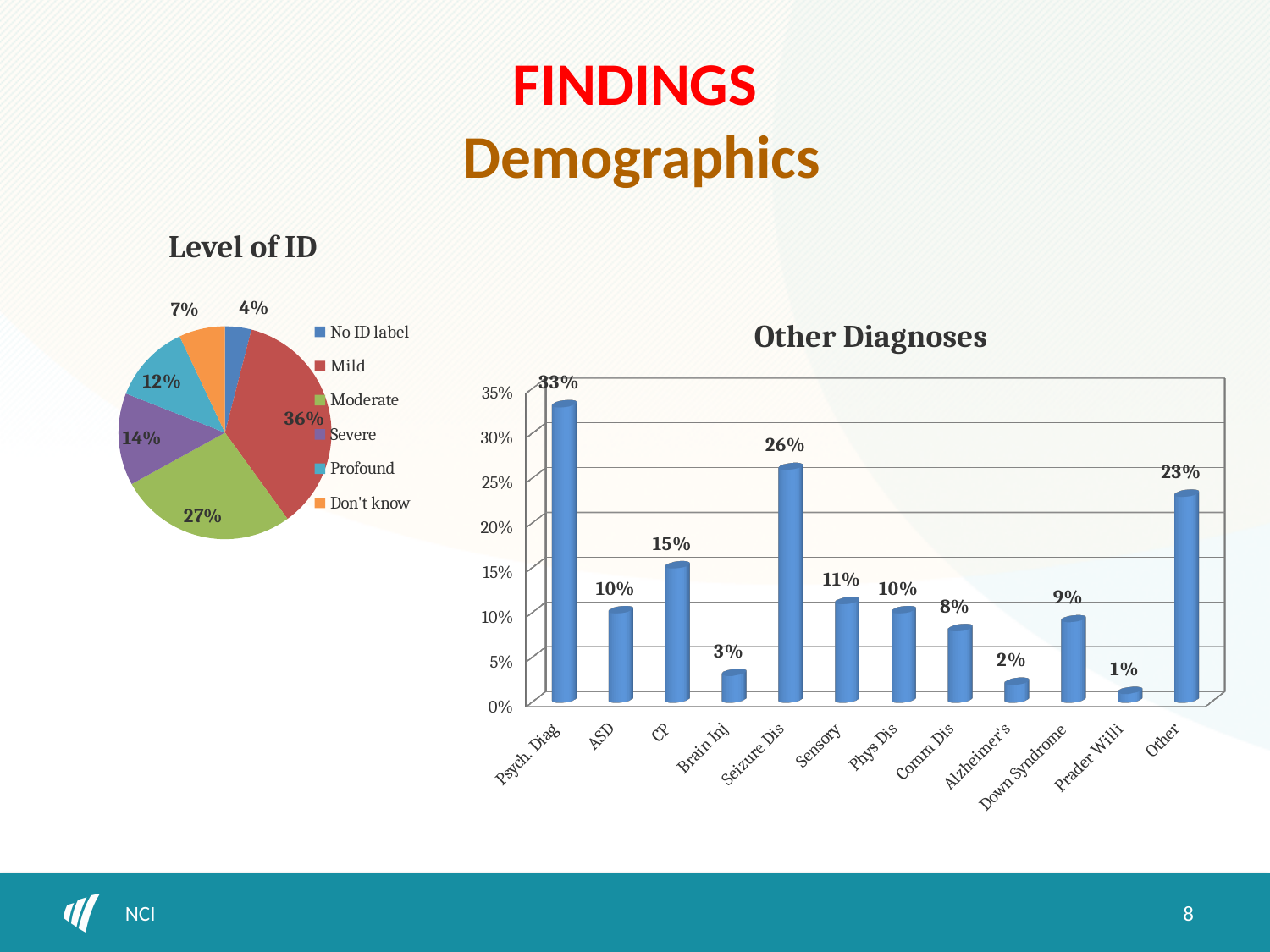
In the Other Diagnoses chart, how many categories are shown on the x axis? 12 What kind of chart is the Other Diagnoses chart? Bar chart In the Other Diagnoses chart, which category has the lowest value? Prader Willi In the Level of ID pie chart, what share is Mild? 36% In the Level of ID pie chart, how many categories does the legend list? 6 What kind of chart is the Level of ID chart? Pie chart In the Level of ID pie chart, which category has the smallest share? No ID label In the Other Diagnoses chart, what is the value for Seizure Dis? 26% In the Other Diagnoses chart, what is the difference between Psych. Diag and Other? 10% In the Other Diagnoses chart, which is larger, CP or Sensory? CP In the Level of ID pie chart, what is the difference between the Moderate and Severe shares? 13% In the Other Diagnoses chart, which category has the highest value? Psych. Diag